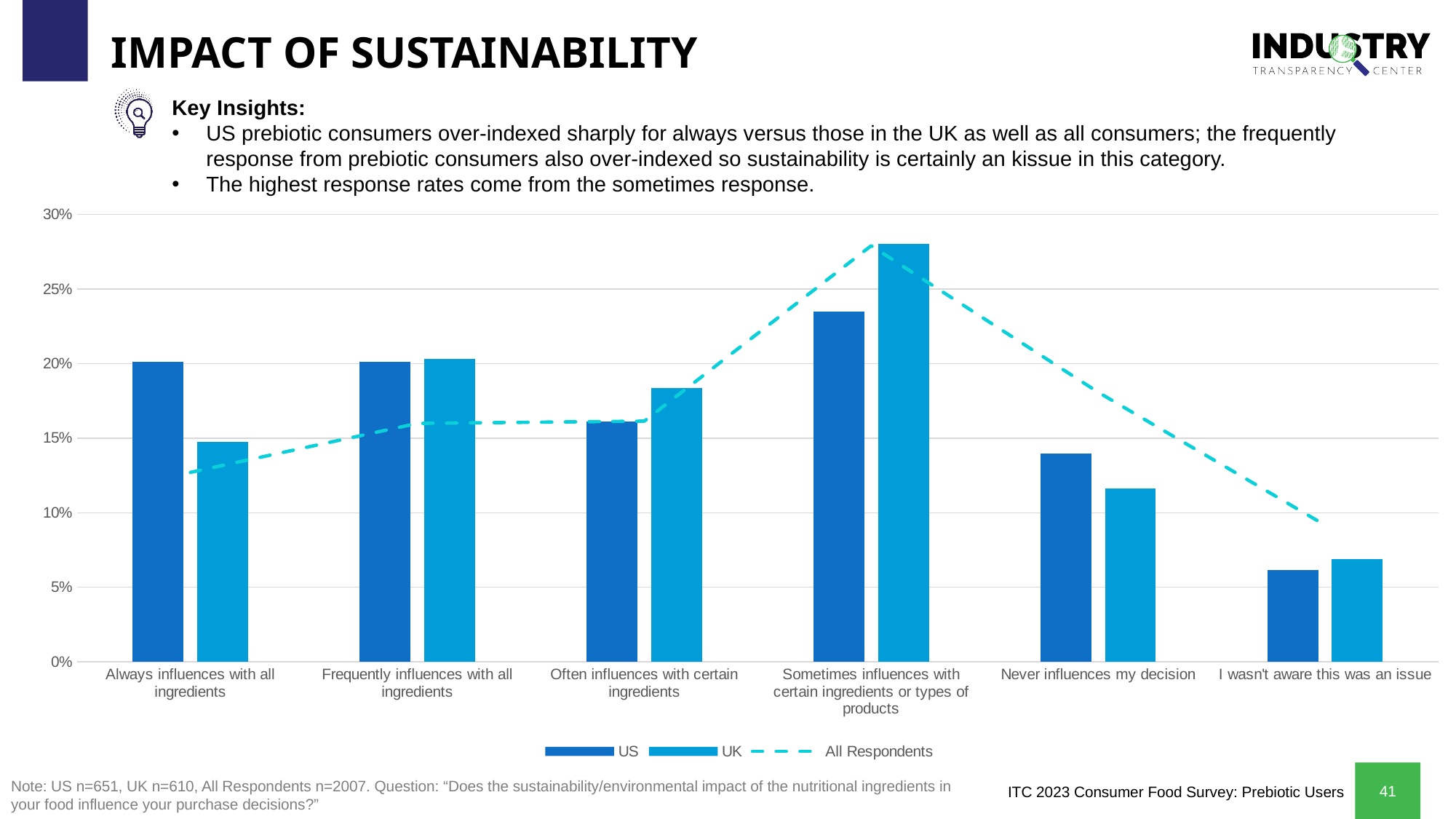
How many response categories are shown on the x axis? 6 Is the US value for 'I wasn't aware this was an issue' greater or less than 10%? less What kind of chart is shown on the slide? combination bar and line chart Which series is drawn as a dashed line rather than bars? All Respondents Which category has the lowest US bar? I wasn't aware this was an issue For 'Never influences my decision', which is larger, the US bar or the UK bar? US For 'Sometimes influences with certain ingredients or types of products', which is larger, the US bar or the UK bar? UK Is the UK value for 'Sometimes influences with certain ingredients or types of products' greater or less than 25%? greater Which category has the highest UK bar? Sometimes influences with certain ingredients or types of products How many series does the legend list? 3 Is the US value for 'Never influences my decision' greater or less than 15%? less For 'Always influences with all ingredients', which is larger, the US bar or the UK bar? US